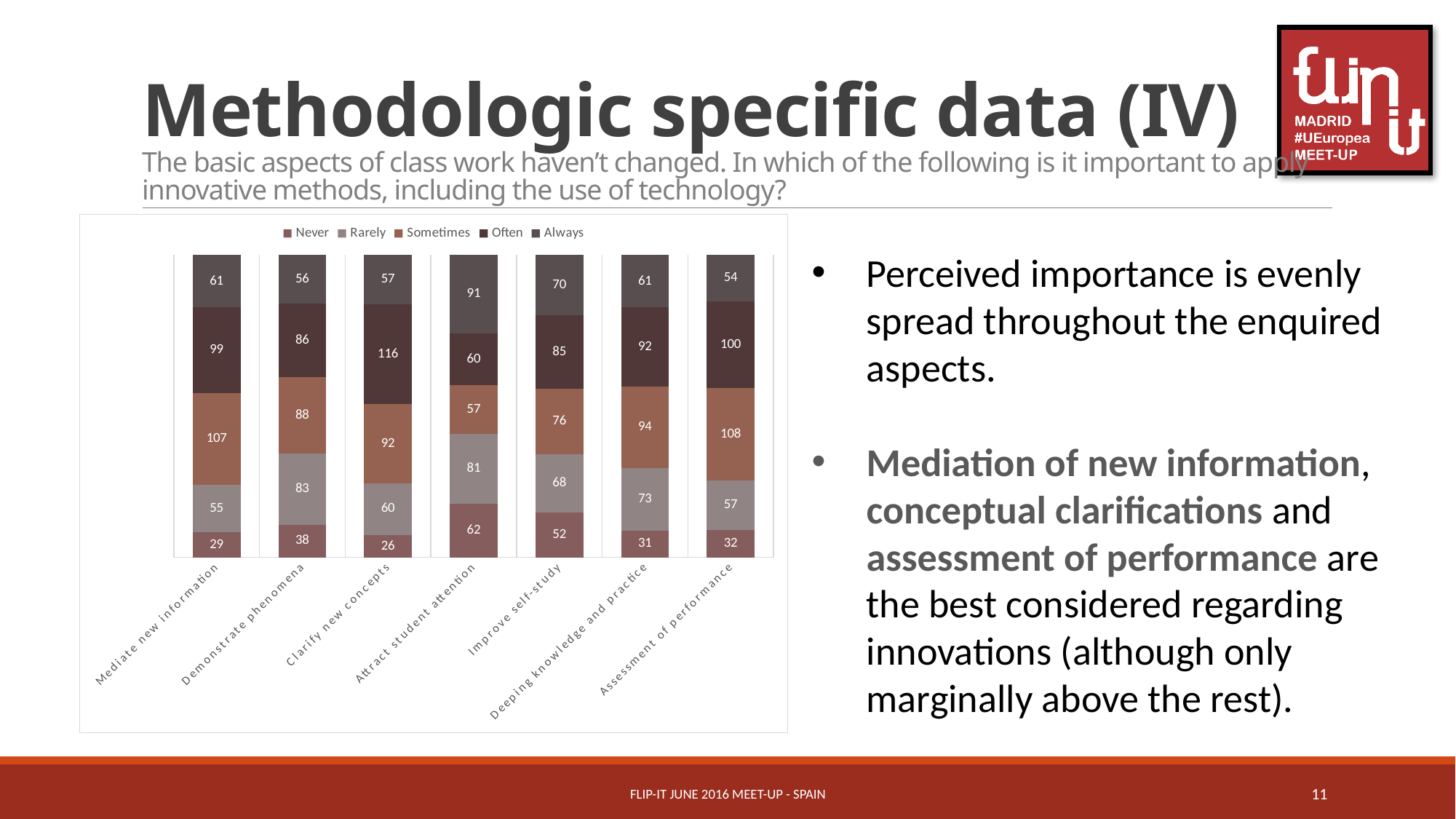
Which is larger, the Rarely value for Attract student attention or the Rarely value for Deeping knowledge and practice? Attract student attention What is the difference between the Sometimes values for Mediate new information and Demonstrate phenomena? 19 How many categories are shown on the x axis? 7 What is the Sometimes value for Assessment of performance? 108 Which category has the lowest Never value? Clarify new concepts Which category has the highest Often value? Clarify new concepts What is the Never value for Attract student attention? 62 What kind of chart is shown on the slide? Stacked bar chart What is the Often value for Clarify new concepts? 116 What is the total of the stacked bar for Mediate new information? 351 What is the Always value for Improve self-study? 70 How many series does the legend list? 5